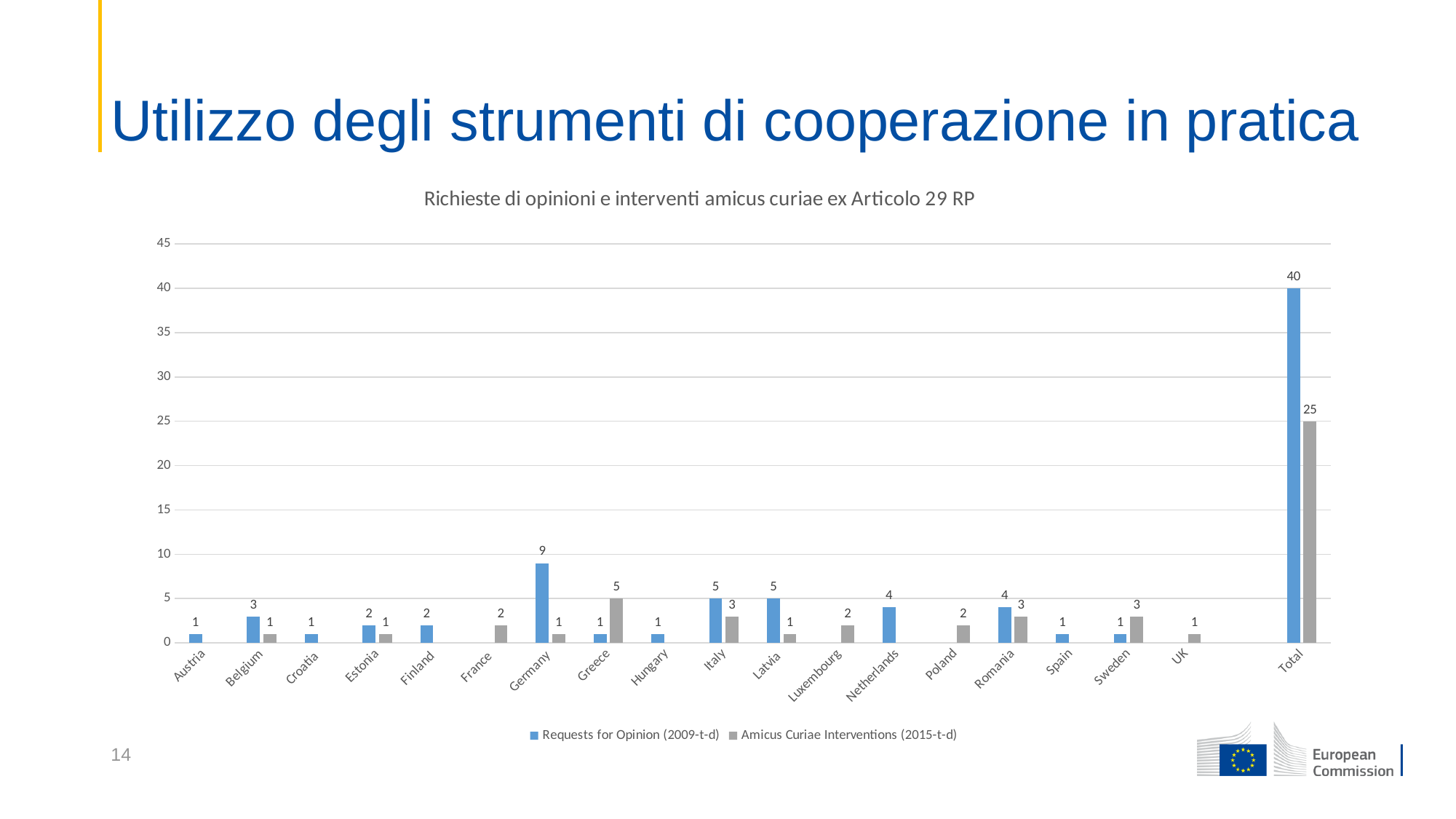
How many categories are shown on the x axis, including Total? 19 How many series does the legend list? 2 Which is larger for Italy: Requests for Opinion (2009-t-d) or Amicus Curiae Interventions (2015-t-d)? Requests for Opinion (2009-t-d) What is the Total value for Amicus Curiae Interventions (2015-t-d)? 25 What kind of chart is shown on the slide? Bar chart Excluding the Total bar, which country has the highest value for Amicus Curiae Interventions (2015-t-d)? Greece What is the value of Amicus Curiae Interventions (2015-t-d) for Greece? 5 What is the title of the chart? Richieste di opinioni e interventi amicus curiae ex Articolo 29 RP What is the value of Requests for Opinion (2009-t-d) for Germany? 9 Excluding the Total bar, which country has the highest value for Requests for Opinion (2009-t-d)? Germany What is the Total value for Requests for Opinion (2009-t-d)? 40 What is the difference between the Total values for Requests for Opinion (2009-t-d) and Amicus Curiae Interventions (2015-t-d)? 15